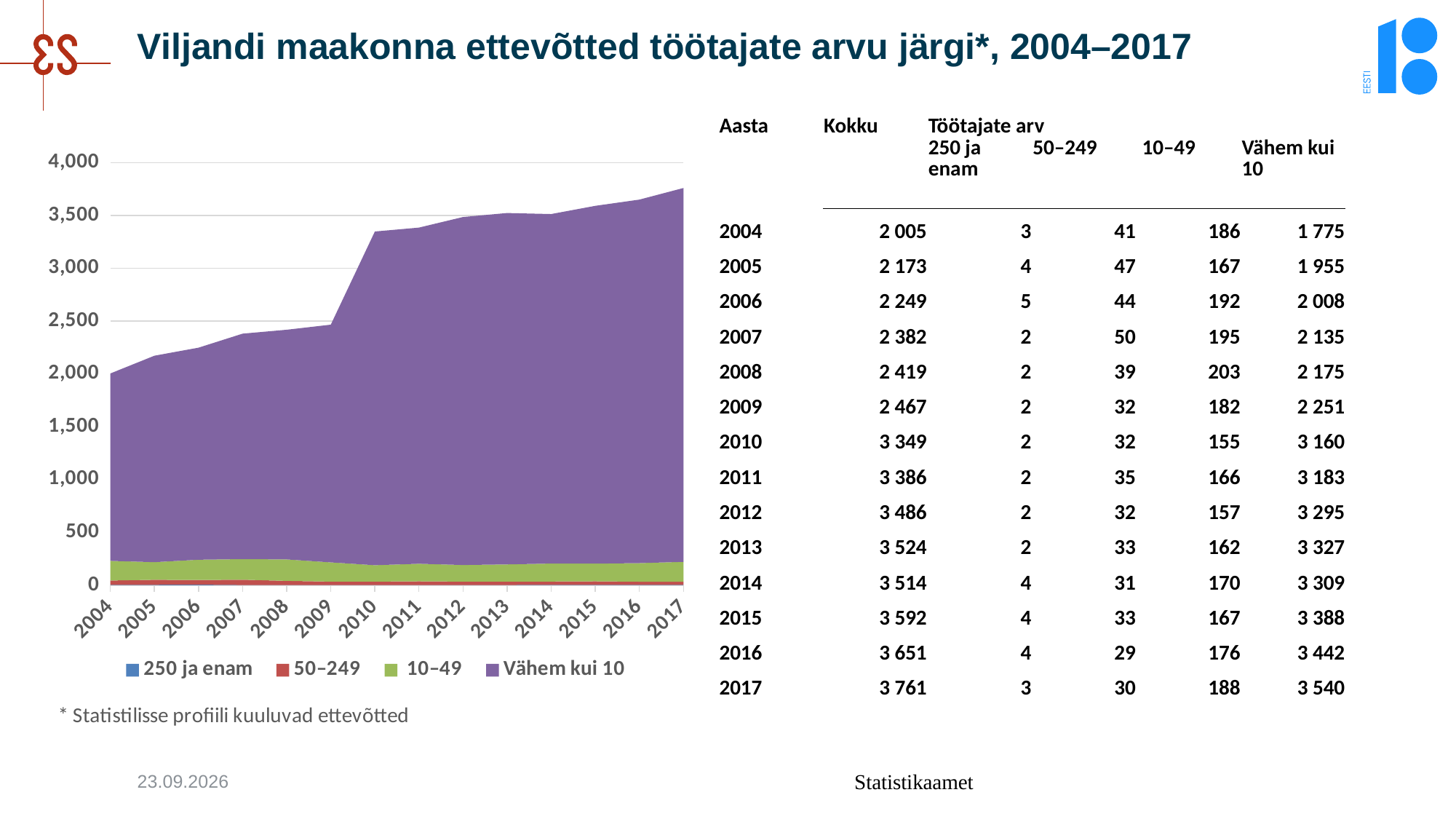
How many series does the chart legend list? 4 According to the table, what is the Kokku value for 2010? 3 349 Is the total value for 2004 greater or less than 2,500? less What kind of chart is shown on the slide? area chart Is the total value for 2017 greater or less than 3,500? greater How many years are plotted along the x axis of the chart? 14 Which colour represents the Vähem kui 10 series in the chart? purple Which year has the highest Kokku value? 2017 Does the total number of enterprises rise or fall from 2004 to 2017? rises Which year has the lowest Kokku value? 2004 According to the table, what is the Vähem kui 10 value for 2017? 3 540 What is the difference between the Kokku values for 2017 and 2004? 1 756